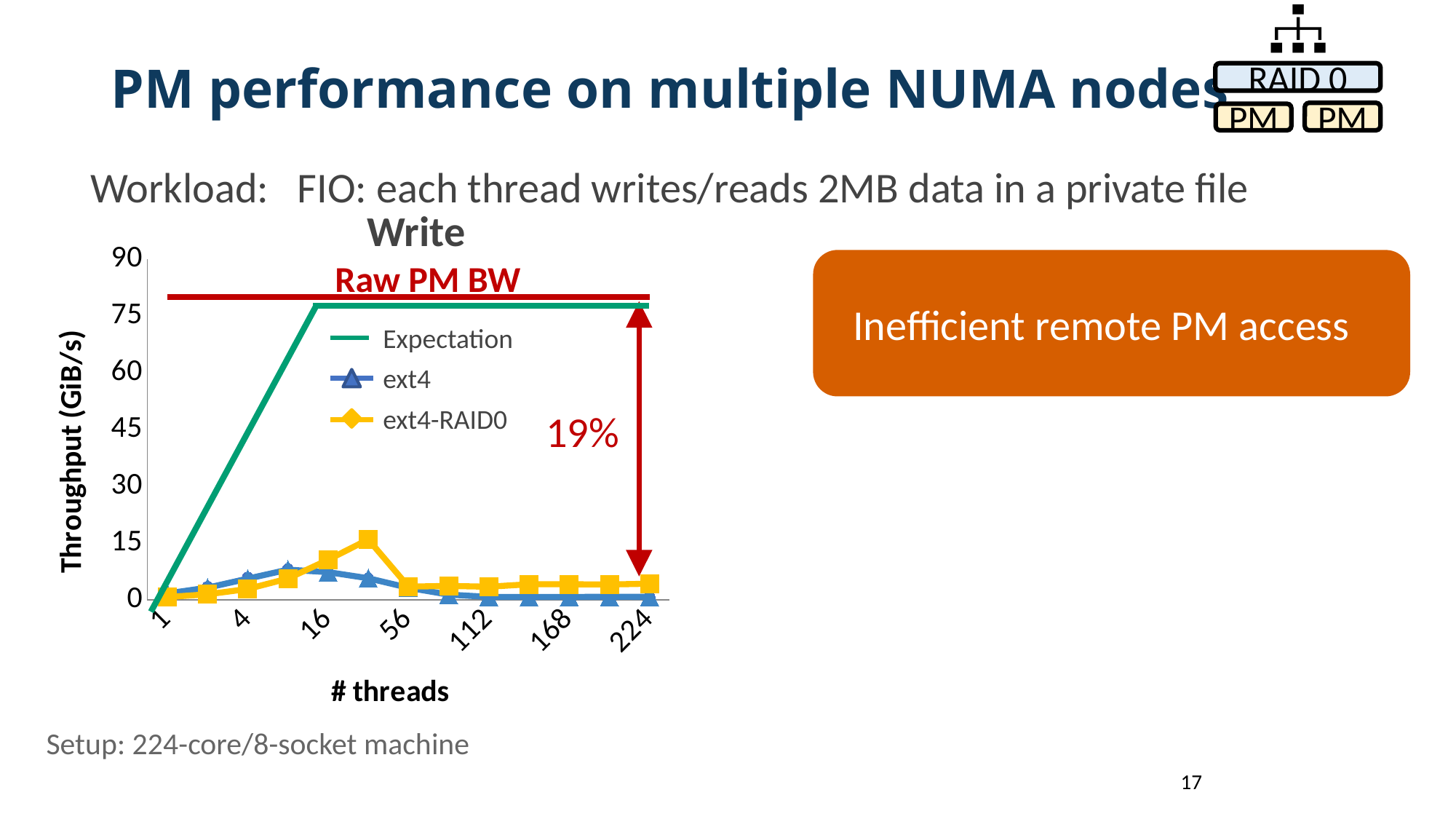
Does the Expectation line rise or fall between 1 and 16 threads? rise How many tick labels are shown on the # threads axis? 7 Is the ext4 value at 224 threads greater or less than 15 GiB/s? less Which series has the lowest throughput at 224 threads? ext4 Is the Expectation value at 224 threads greater or less than 60 GiB/s? greater Is the peak ext4-RAID0 value greater or less than 30 GiB/s? less What is the label of the y axis? Throughput (GiB/s) Which series reaches the highest throughput in the chart? Expectation At 224 threads, which is larger: ext4-RAID0 or ext4? ext4-RAID0 What kind of chart is shown on the slide? line chart What percentage is annotated next to the red arrow on the chart? 19% How many series does the chart legend list? 3